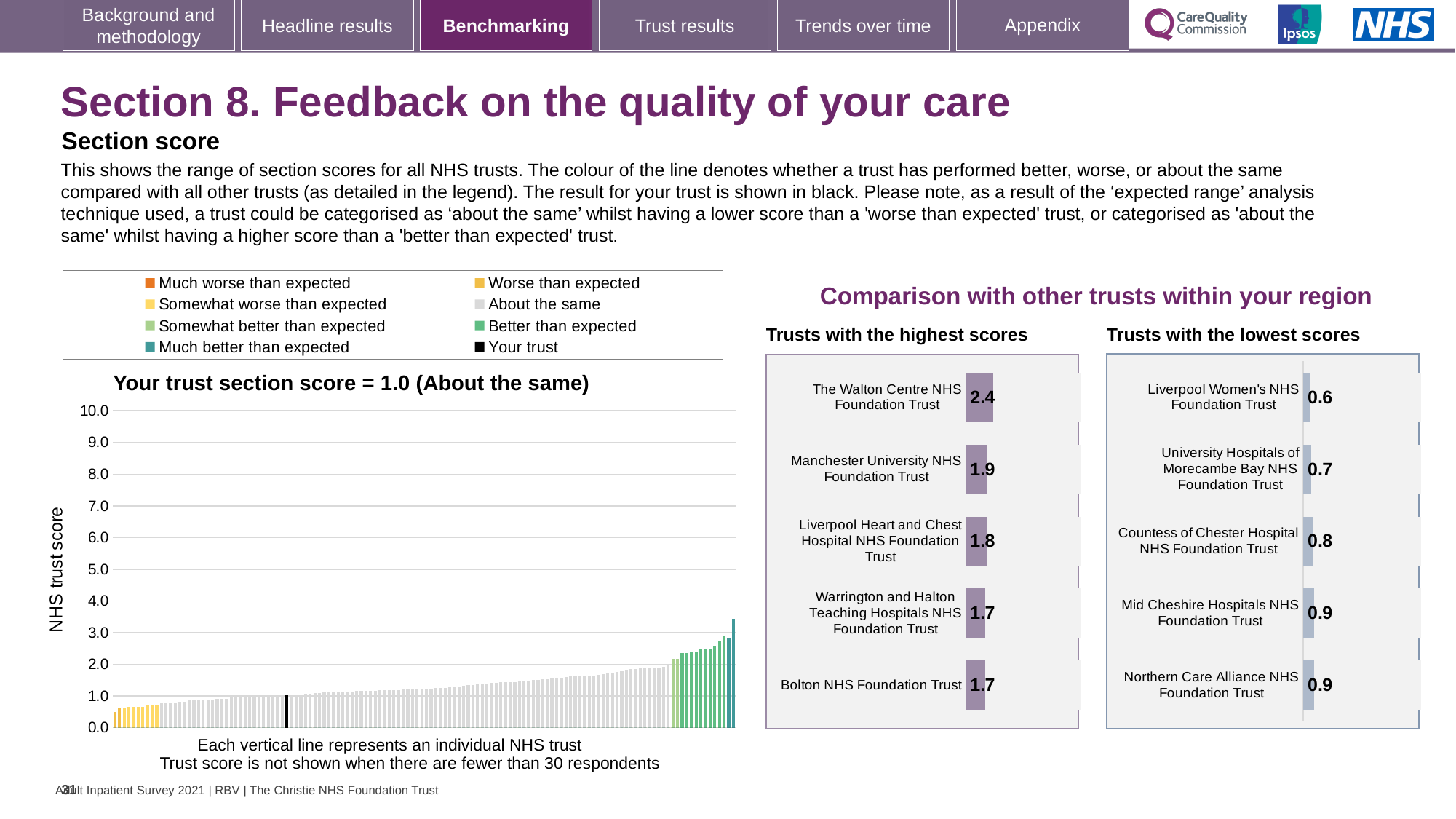
In the main 'Your trust section score' chart, do the bar values rise or fall from left to right? rise In the 'Trusts with the lowest scores' chart, what is the score for Liverpool Women's NHS Foundation Trust? 0.6 In the 'Trusts with the highest scores' chart, which trust has the highest score? The Walton Centre NHS Foundation Trust In the 'Trusts with the highest scores' chart, what is the difference between the scores of The Walton Centre NHS Foundation Trust and Bolton NHS Foundation Trust? 0.7 In the 'Trusts with the highest scores' chart, what is the score for The Walton Centre NHS Foundation Trust? 2.4 In the main 'Your trust section score' chart, is the tallest bar greater or less than 3.0? greater In the 'Trusts with the lowest scores' chart, what is the score for Mid Cheshire Hospitals NHS Foundation Trust? 0.9 In the 'Trusts with the highest scores' chart, how many trusts are shown? 5 In the 'Trusts with the lowest scores' chart, which trust has the lowest score? Liverpool Women's NHS Foundation Trust How many entries does the legend above the main chart list? 8 In the 'Trusts with the lowest scores' chart, which has the larger score: Countess of Chester Hospital NHS Foundation Trust or University Hospitals of Morecambe Bay NHS Foundation Trust? Countess of Chester Hospital NHS Foundation Trust In the main 'Your trust section score' chart, what is the section score for your trust? 1.0